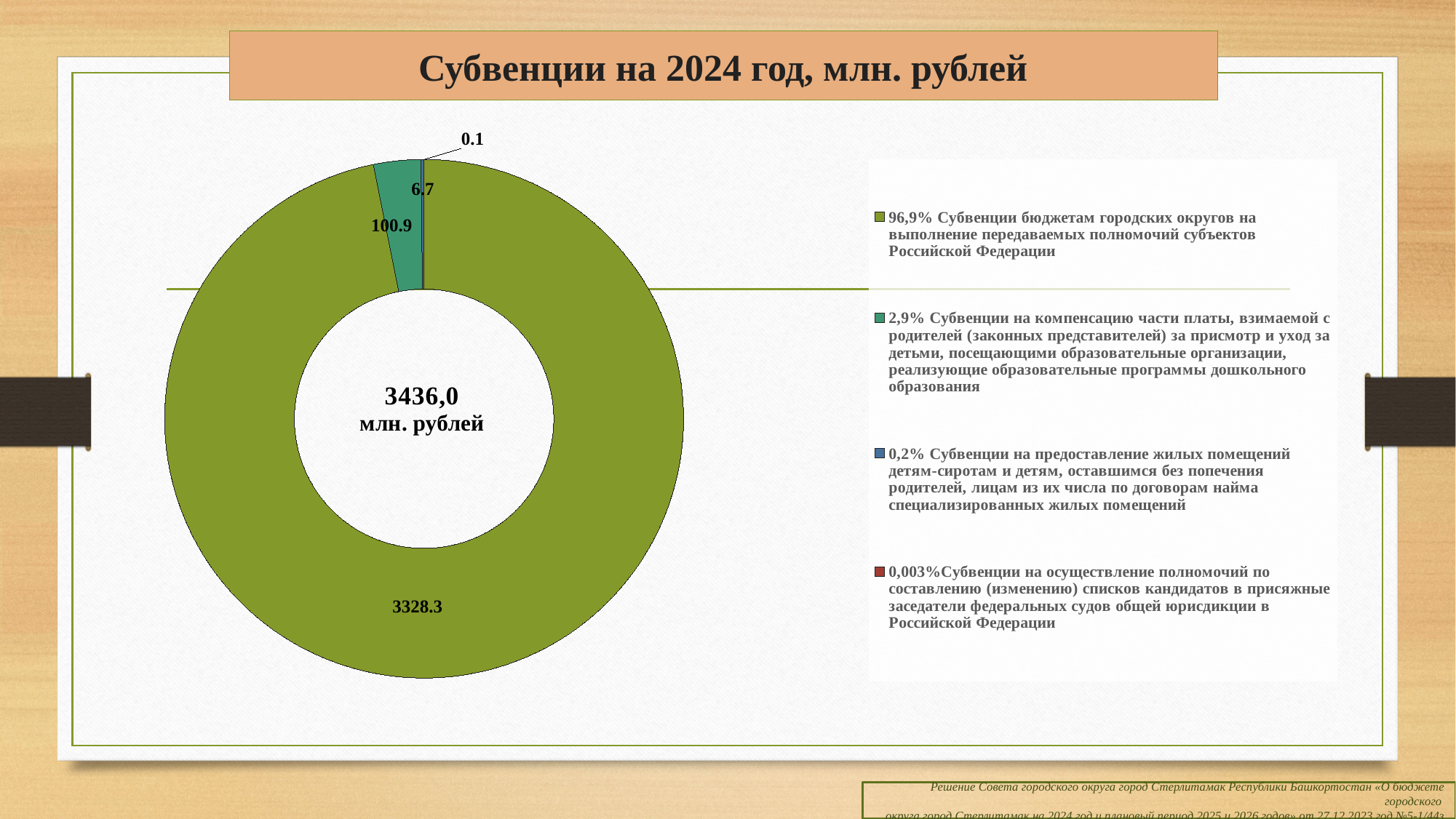
What kind of chart is shown on the slide? doughnut chart Which segment has the smallest value in the doughnut chart? Субвенции на осуществление полномочий по составлению (изменению) списков кандидатов в присяжные заседатели федеральных судов общей юрисдикции в Российской Федерации What value is shown for the segment 'Субвенции на осуществление полномочий по составлению (изменению) списков кандидатов в присяжные заседатели'? 0.1 What value is shown for the segment 'Субвенции бюджетам городских округов на выполнение передаваемых полномочий субъектов Российской Федерации'? 3328.3 What value is shown for the segment 'Субвенции на предоставление жилых помещений детям-сиротам и детям, оставшимся без попечения родителей'? 6.7 What is the title of the chart on the slide? Субвенции на 2024 год, млн. рублей What total value is shown in the centre of the doughnut chart? 3436,0 млн. рублей Which segment has the largest value in the doughnut chart? Субвенции бюджетам городских округов на выполнение передаваемых полномочий субъектов Российской Федерации How many segments does the doughnut chart have? 4 What share of the total do the subventions for compensation of part of parental fees (Субвенции на компенсацию части платы) represent, according to the legend? 2,9% What is the difference between the values 100.9 and 6.7 shown on the chart? 94.2 What value is shown for the segment 'Субвенции на компенсацию части платы, взимаемой с родителей (законных представителей) за присмотр и уход за детьми'? 100.9